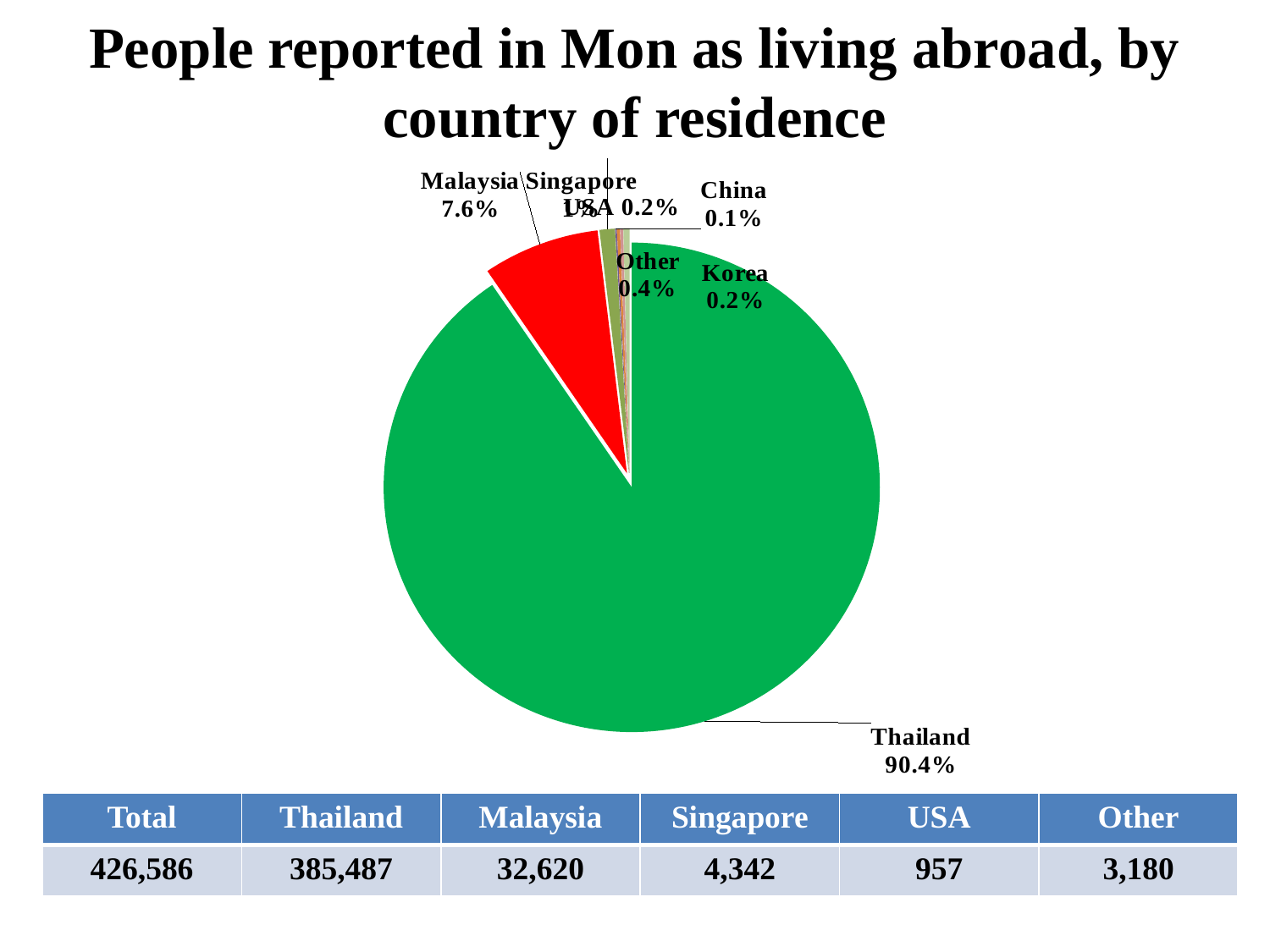
How many slices are labelled in the pie chart? 7 What percentage is shown for China? 0.1% What kind of chart is shown on the slide? pie chart What percentage is shown for Malaysia? 7.6% Which country has the largest slice of the pie? Thailand Which has the larger share, Malaysia or Other? Malaysia What share of the pie does Thailand account for? 90.4% What percentage is shown for the Other category? 0.4% How many percentage points larger is Thailand's share than Malaysia's? 82.8 percentage points What percentage is shown for Korea? 0.2% What is the title of the chart? People reported in Mon as living abroad, by country of residence Which labelled category has the smallest share of the pie? China